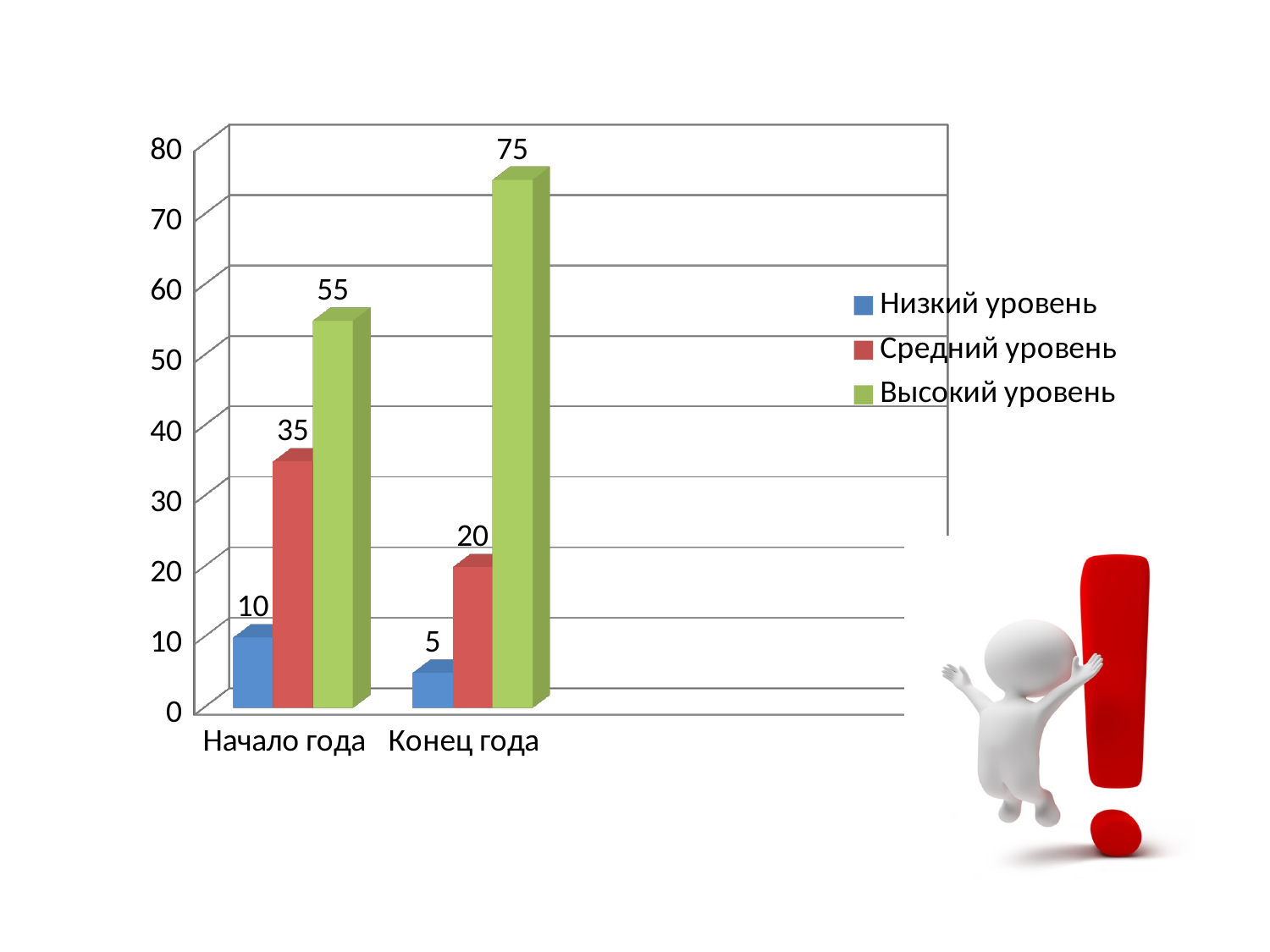
How many categories are shown on the x axis? 2 What is the value for Высокий уровень at Начало года? 55 What is the value for Высокий уровень at Конец года? 75 What is the value for Низкий уровень at Начало года? 10 Which is larger: Средний уровень at Начало года or Средний уровень at Конец года? Начало года Does the Низкий уровень value rise or fall from Начало года to Конец года? Fall Which series has the highest value at Конец года? Высокий уровень Which series has the lowest value at Начало года? Низкий уровень What is the value for Средний уровень at Конец года? 20 What kind of chart is shown on the slide? Bar chart What is the difference between the Высокий уровень values at Конец года and Начало года? 20 How many series does the legend list? 3